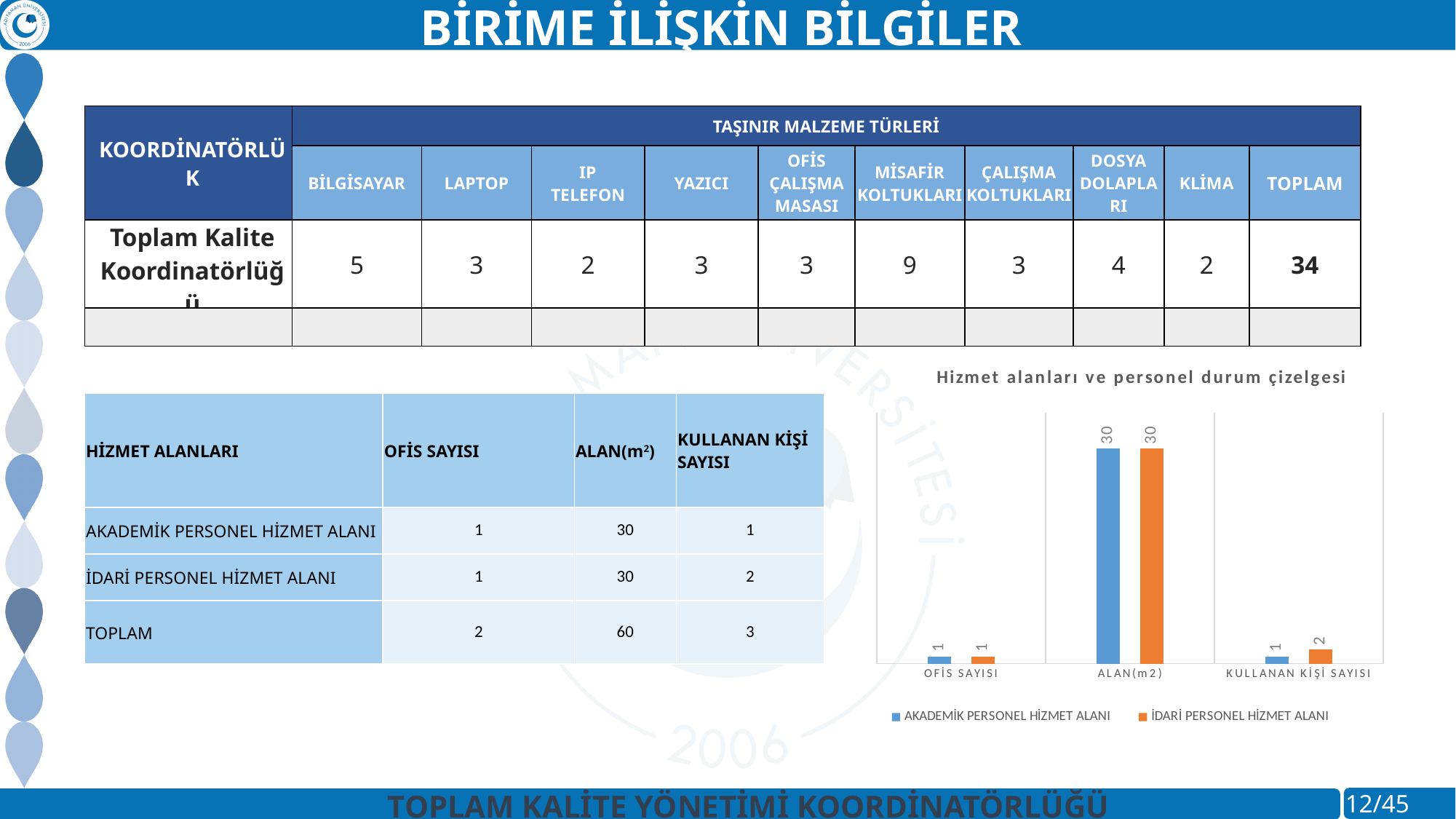
How many categories are shown on the x axis of the chart? 3 What is the value for İDARİ PERSONEL HİZMET ALANI in the KULLANAN KİŞİ SAYISI category? 2 What is the value for AKADEMİK PERSONEL HİZMET ALANI in the OFİS SAYISI category? 1 In the KULLANAN KİŞİ SAYISI category, which series has the larger value? İDARİ PERSONEL HİZMET ALANI What is the title of the chart on the slide? Hizmet alanları ve personel durum çizelgesi What is the difference between the ALAN(M2) value and the OFİS SAYISI value for AKADEMİK PERSONEL HİZMET ALANI? 29 Which colour represents İDARİ PERSONEL HİZMET ALANI in the chart? orange Which category has the highest values in the chart? ALAN(M2) How many series does the chart legend list? 2 What is the value for AKADEMİK PERSONEL HİZMET ALANI in the ALAN(M2) category? 30 What type of chart is shown on the slide? bar chart What is the difference between the İDARİ PERSONEL HİZMET ALANI and AKADEMİK PERSONEL HİZMET ALANI values in the KULLANAN KİŞİ SAYISI category? 1